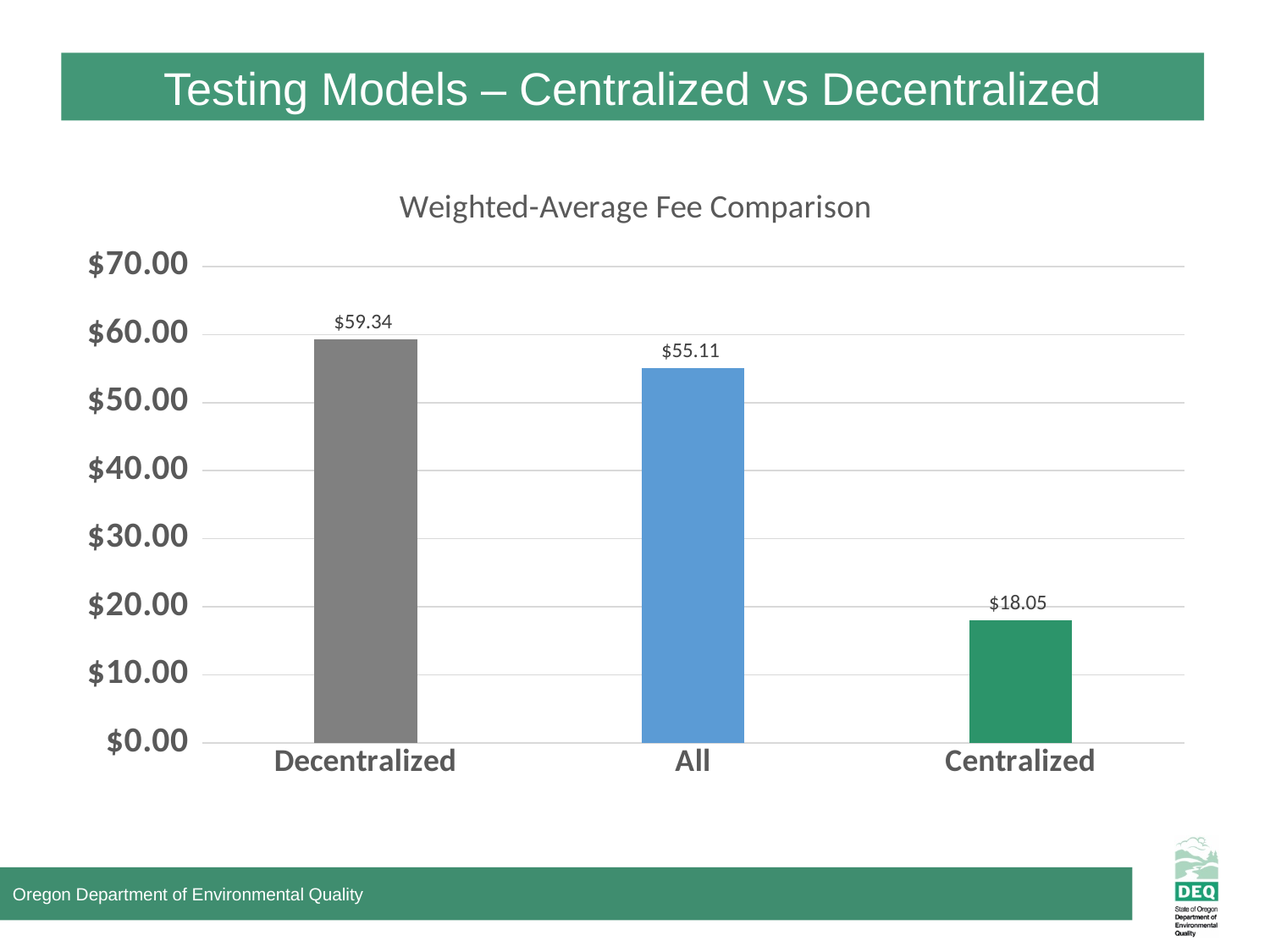
What is the difference between the Decentralized and All fees? $4.23 What is the weighted-average fee for Centralized? $18.05 Which is larger, the fee for All or the fee for Centralized? All Which category has the lowest weighted-average fee? Centralized Which category has the highest weighted-average fee? Decentralized What is the title of the chart? Weighted-Average Fee Comparison How many categories are shown on the x axis? 3 What kind of chart is shown on the slide? Bar chart Is the value for Centralized greater or less than $20.00? less What is the weighted-average fee for Decentralized? $59.34 What is the difference between the Decentralized and Centralized fees? $41.29 What is the weighted-average fee for All? $55.11